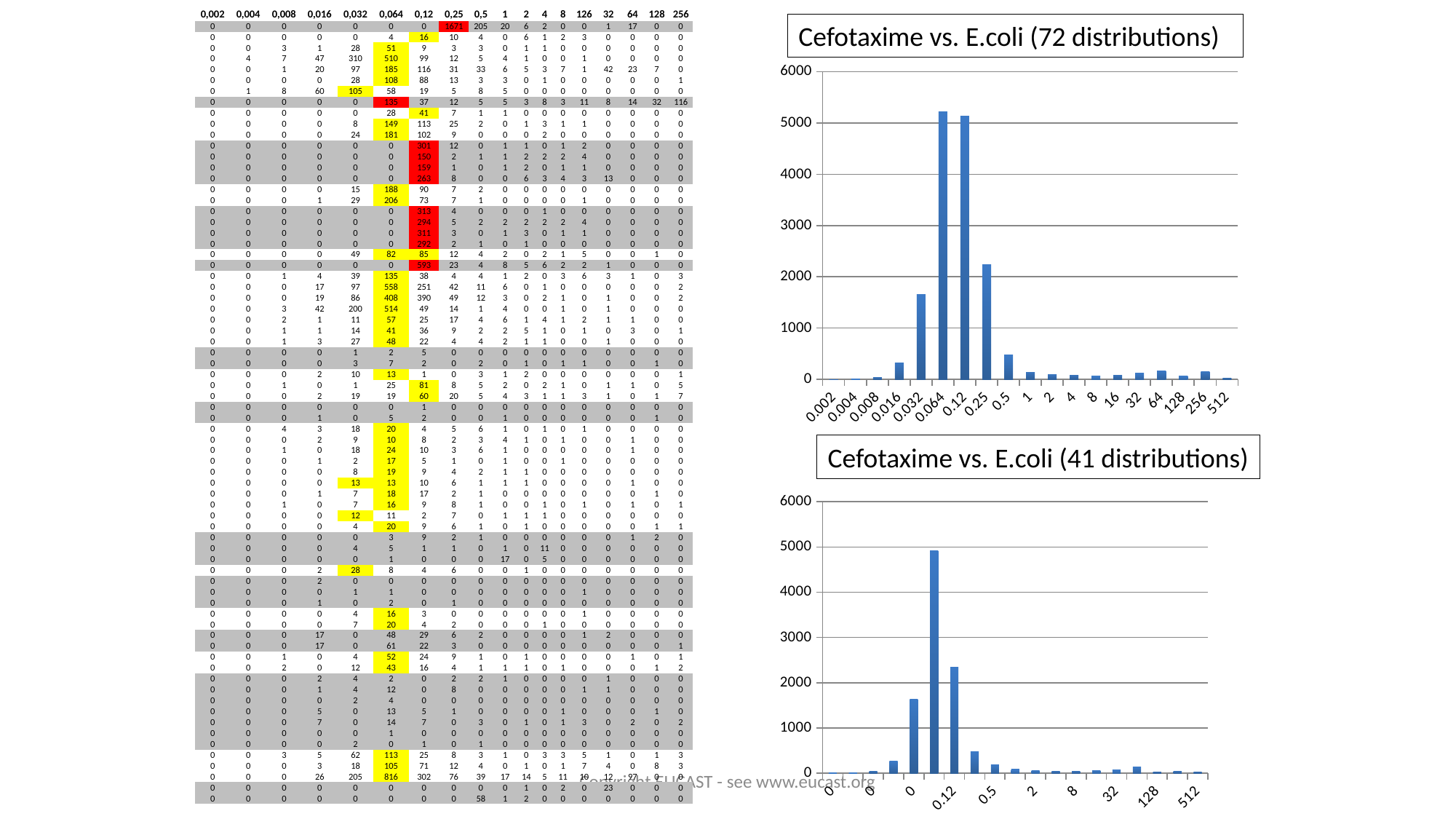
What kind of chart is the 'Cefotaxime vs. E.coli (41 distributions)' chart? bar chart In the 'Cefotaxime vs. E.coli (72 distributions)' chart, which is larger, the value for 0.032 or the value for 0.25? 0.25 In the 'Cefotaxime vs. E.coli (72 distributions)' chart, is the value for 0.064 greater or less than 5000? greater In the 'Cefotaxime vs. E.coli (41 distributions)' chart, is the value for 0.5 greater or less than 1000? less In the 'Cefotaxime vs. E.coli (72 distributions)' chart, do the values rise or fall from 0.12 to 0.5 along the x axis? fall How many categories are shown on the x axis of the 'Cefotaxime vs. E.coli (72 distributions)' chart? 19 In the 'Cefotaxime vs. E.coli (41 distributions)' chart, is the value for 0.12 greater or less than 2000? greater What kind of chart is the 'Cefotaxime vs. E.coli (72 distributions)' chart? bar chart What is the highest value shown on the y axis of the 'Cefotaxime vs. E.coli (72 distributions)' chart? 6000